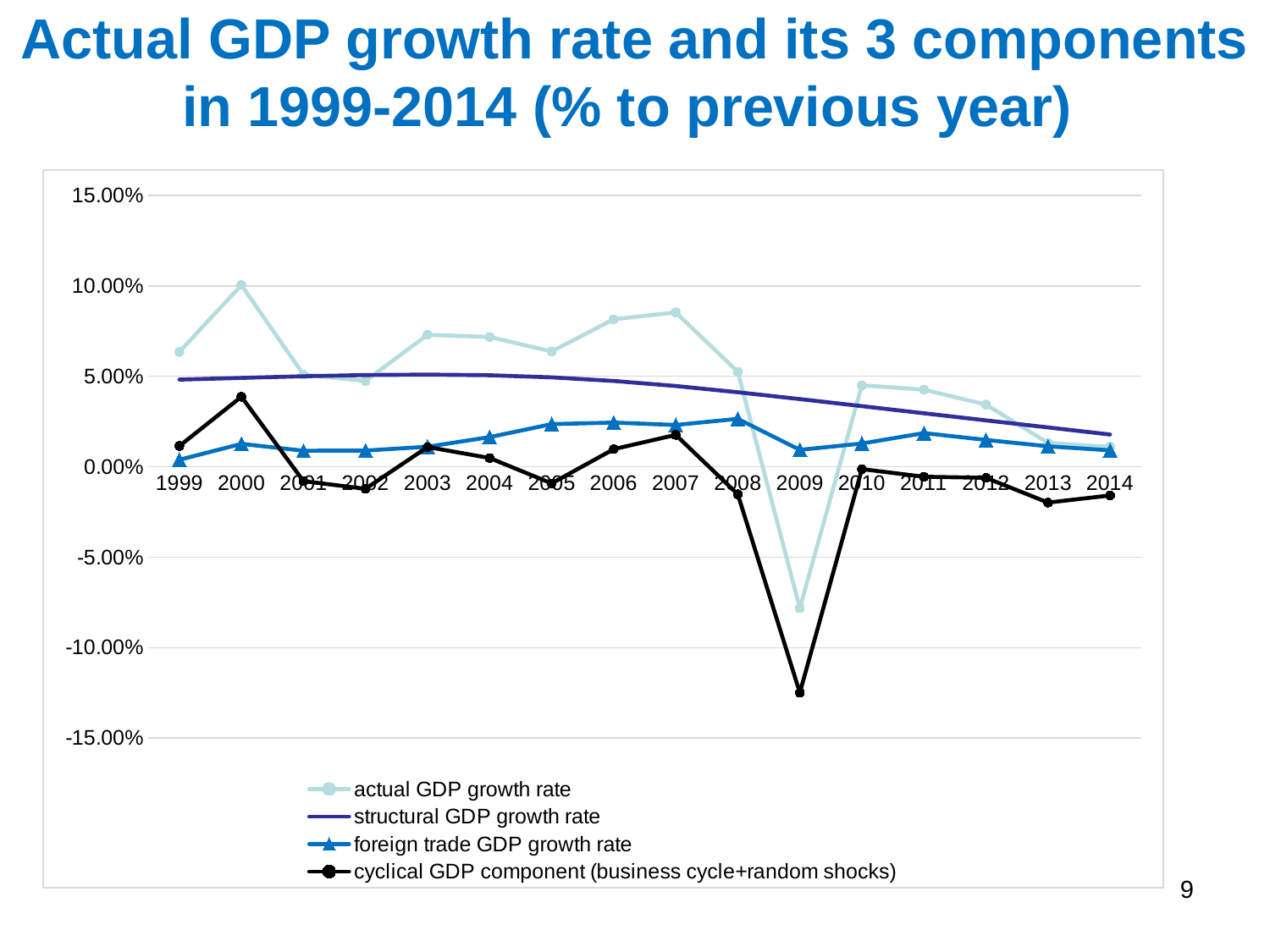
How many years are plotted along the x axis? 16 In which year is the actual GDP growth rate highest? 2000 In which year is the cyclical GDP component lowest? 2009 Is the actual GDP growth rate in 2009 greater or less than -5.00%? less Is the cyclical GDP component in 2009 greater or less than -10.00%? less Which series is drawn with the black line and circle markers? cyclical GDP component (business cycle+random shocks) Which is larger, the actual GDP growth rate in 2007 or in 2008? 2007 What kind of chart is shown on the slide? line chart Is the actual GDP growth rate in 2007 greater or less than 5.00%? greater Does the structural GDP growth rate rise or fall from 2003 to 2014? fall In which year is the actual GDP growth rate lowest? 2009 How many series does the legend list? 4